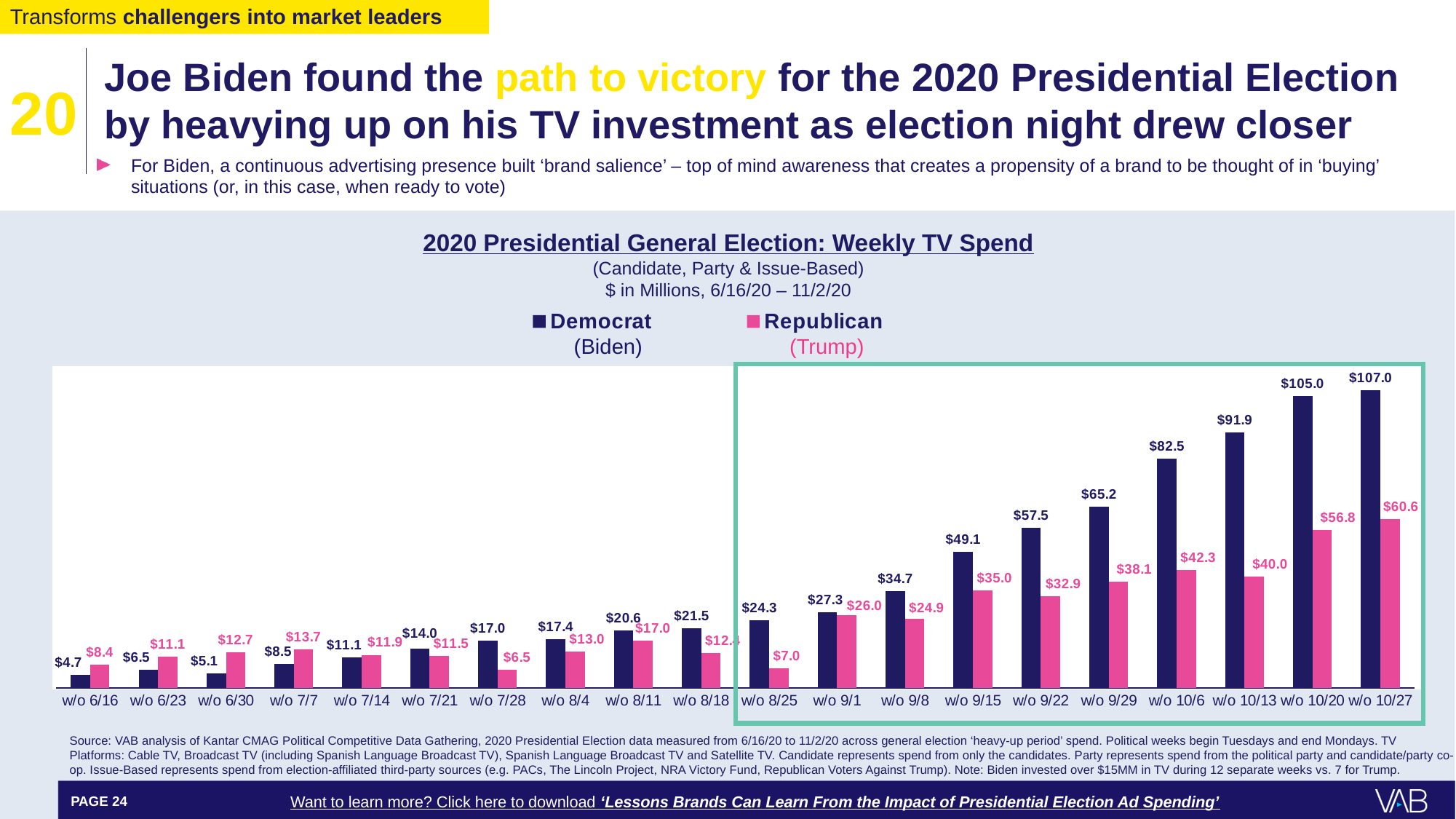
How many weeks are shown on the x axis of the chart? 20 What was the Democrat (Biden) weekly TV spend for w/o 10/27? $107.0 Does the Democrat (Biden) weekly TV spend generally rise or fall from w/o 6/16 to w/o 10/27? Rise What was the Democrat (Biden) weekly TV spend for w/o 8/11? $20.6 For w/o 10/20, how much more did the Democrat (Biden) spend than the Republican (Trump)? $48.2 What kind of chart is used to show the weekly TV spend? Bar chart What was the Republican (Trump) weekly TV spend for w/o 9/15? $35.0 In which week was the Democrat (Biden) TV spend lowest? w/o 6/16 How many series does the chart's legend list? 2 In which week was the Democrat (Biden) TV spend highest? w/o 10/27 For w/o 6/30, which series had the larger TV spend, Democrat (Biden) or Republican (Trump)? Republican (Trump) In which week was the Republican (Trump) TV spend lowest? w/o 7/28